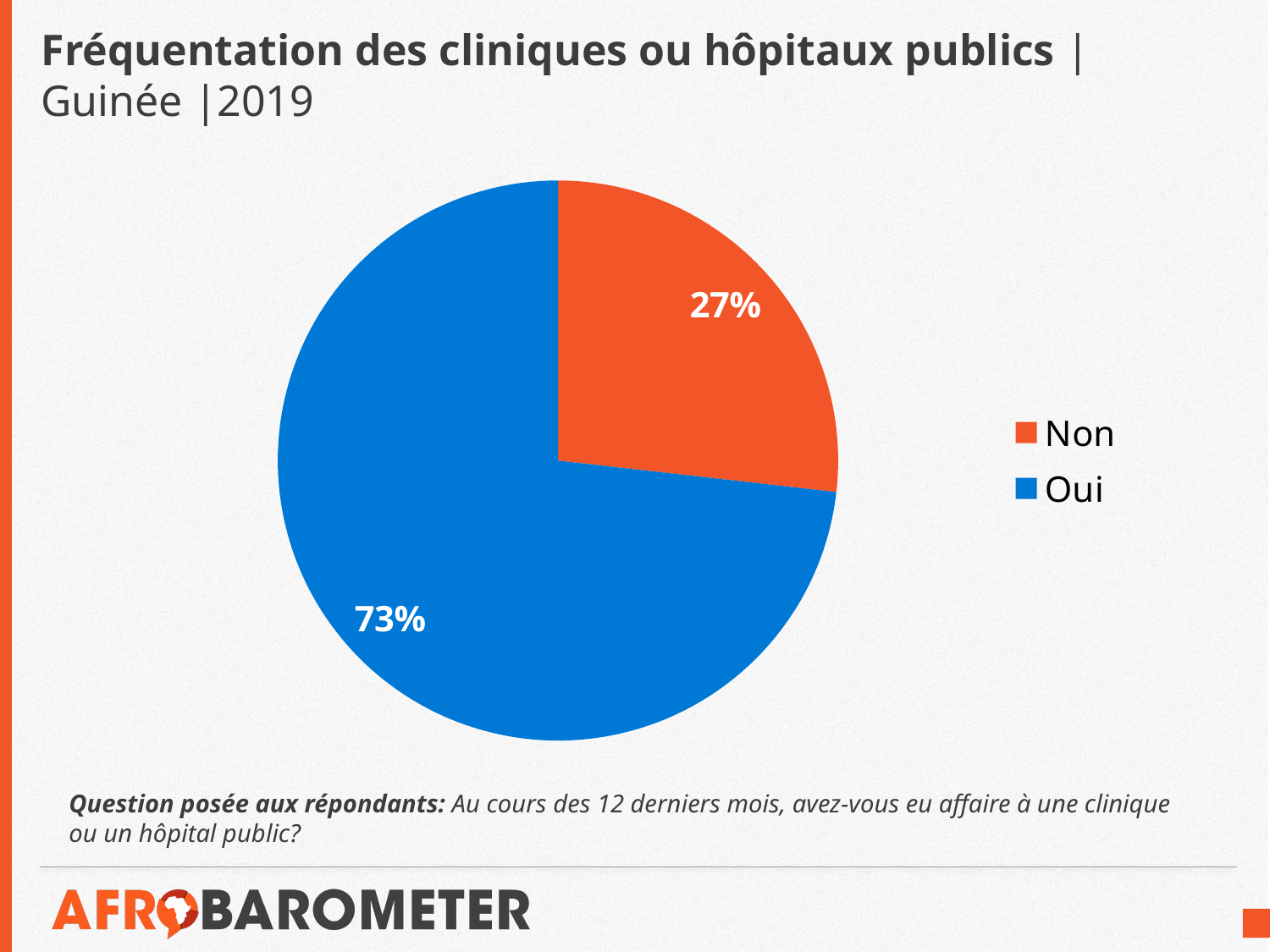
What is the difference in percentage points between "Oui" and "Non"? 46 How many categories are shown in the pie chart? 2 What percentage of respondents answered "Oui"? 73% Which category has the smallest share of the pie? Non Which country and year does the chart title refer to? Guinée, 2019 What percentage of respondents answered "Non"? 27% What colour is the "Oui" slice? Blue Which is larger, the share for "Oui" or the share for "Non"? Oui Which category has the largest share of the pie? Oui What share of the pie does the "Non" slice represent? 27% What kind of chart is shown on the slide? Pie chart